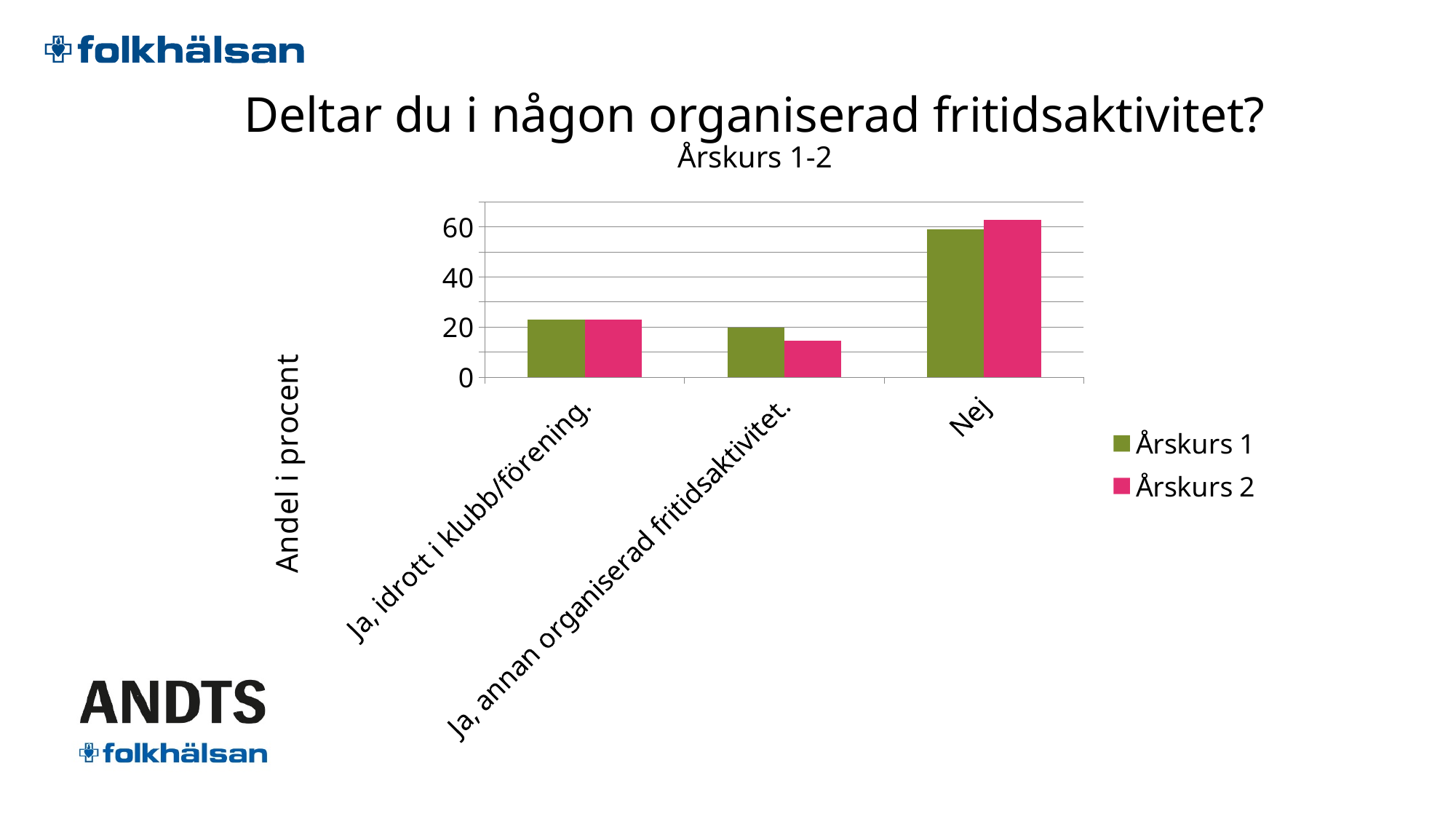
Is the value for Årskurs 2 in the category Ja, annan organiserad fritidsaktivitet. greater or less than 20? less Which category has the highest value for Årskurs 2? Nej Which category has the highest value for Årskurs 1? Nej Is the value for Årskurs 2 in the category Nej greater or less than 60? greater What is the title of the vertical axis? Andel i procent Which category has the lowest value for Årskurs 2? Ja, annan organiserad fritidsaktivitet. How many categories are shown on the x axis? 3 For the category Ja, annan organiserad fritidsaktivitet., which series has the larger value, Årskurs 1 or Årskurs 2? Årskurs 1 For the category Nej, which series has the larger value, Årskurs 1 or Årskurs 2? Årskurs 2 What kind of chart is shown on the slide? bar chart How many series does the legend list? 2 Is the value for Årskurs 1 in the category Nej greater or less than 40? greater